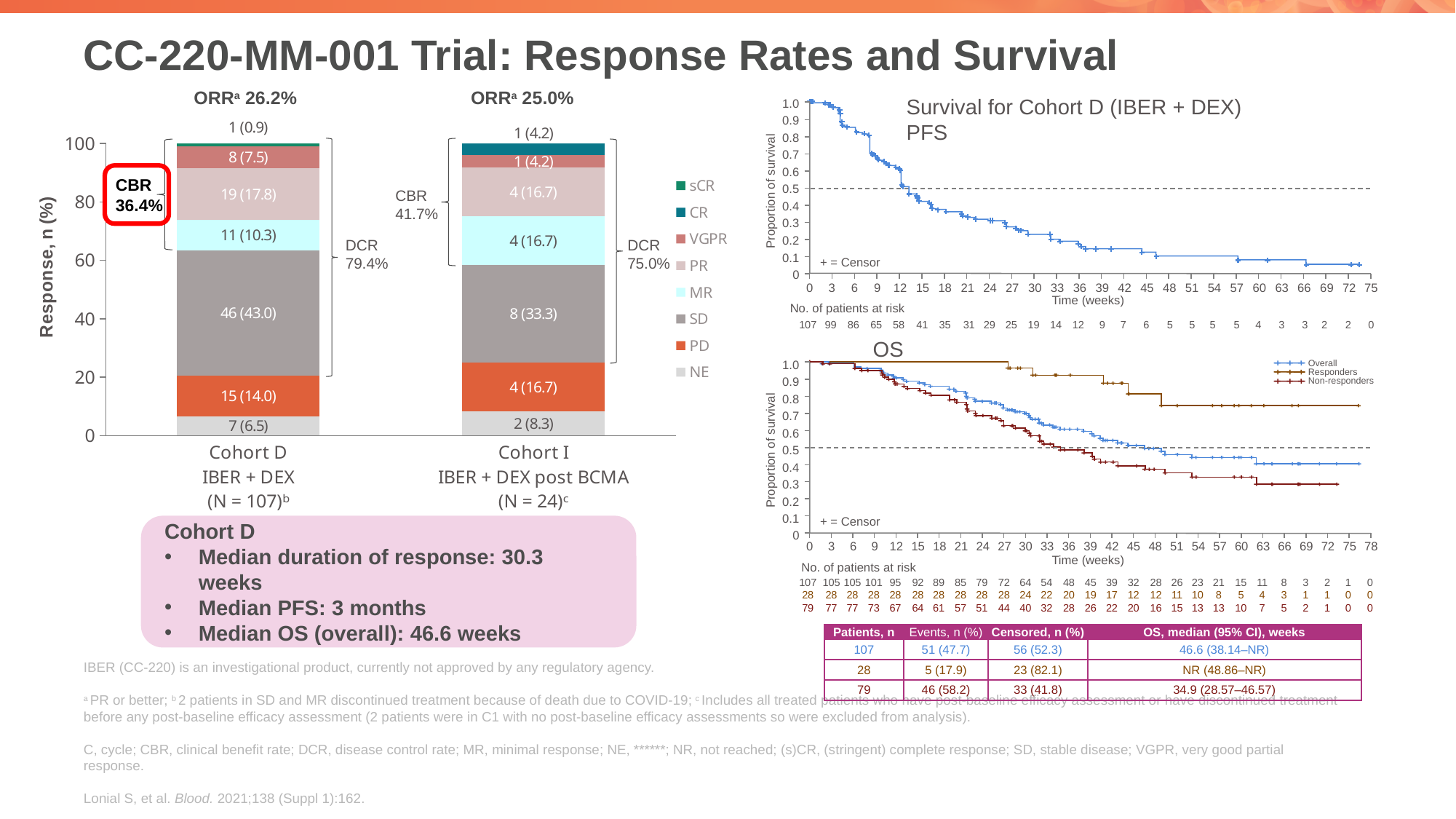
In the stacked bar chart of response rates, what is the value shown for the PD segment of Cohort I? 4 (16.7) In the stacked bar chart of response rates, what is the difference in patient count between the SD and PD segments of Cohort D? 31 In the PFS survival chart for Cohort D, is the proportion of survival at 24 weeks greater or less than 0.5? less What type of chart is used to show the response rates for Cohort D and Cohort I? Stacked bar chart In the PFS survival chart for Cohort D, how many patients are at risk at 12 weeks? 58 In the stacked bar chart of response rates, what is the value shown for the SD segment of Cohort D? 46 (43.0) In the stacked bar chart of response rates, which is larger: the PR segment of Cohort D or the MR segment of Cohort D? PR segment of Cohort D In the stacked bar chart of response rates, how many cohorts are plotted? 2 In the stacked bar chart of response rates, which segment of the Cohort I bar is the largest? SD In the stacked bar chart of response rates, how many response categories does the legend list? 8 In the OS survival chart, how many groups does the legend list? 3 In the stacked bar chart of response rates, what ORR is shown above the Cohort D bar? 26.2%